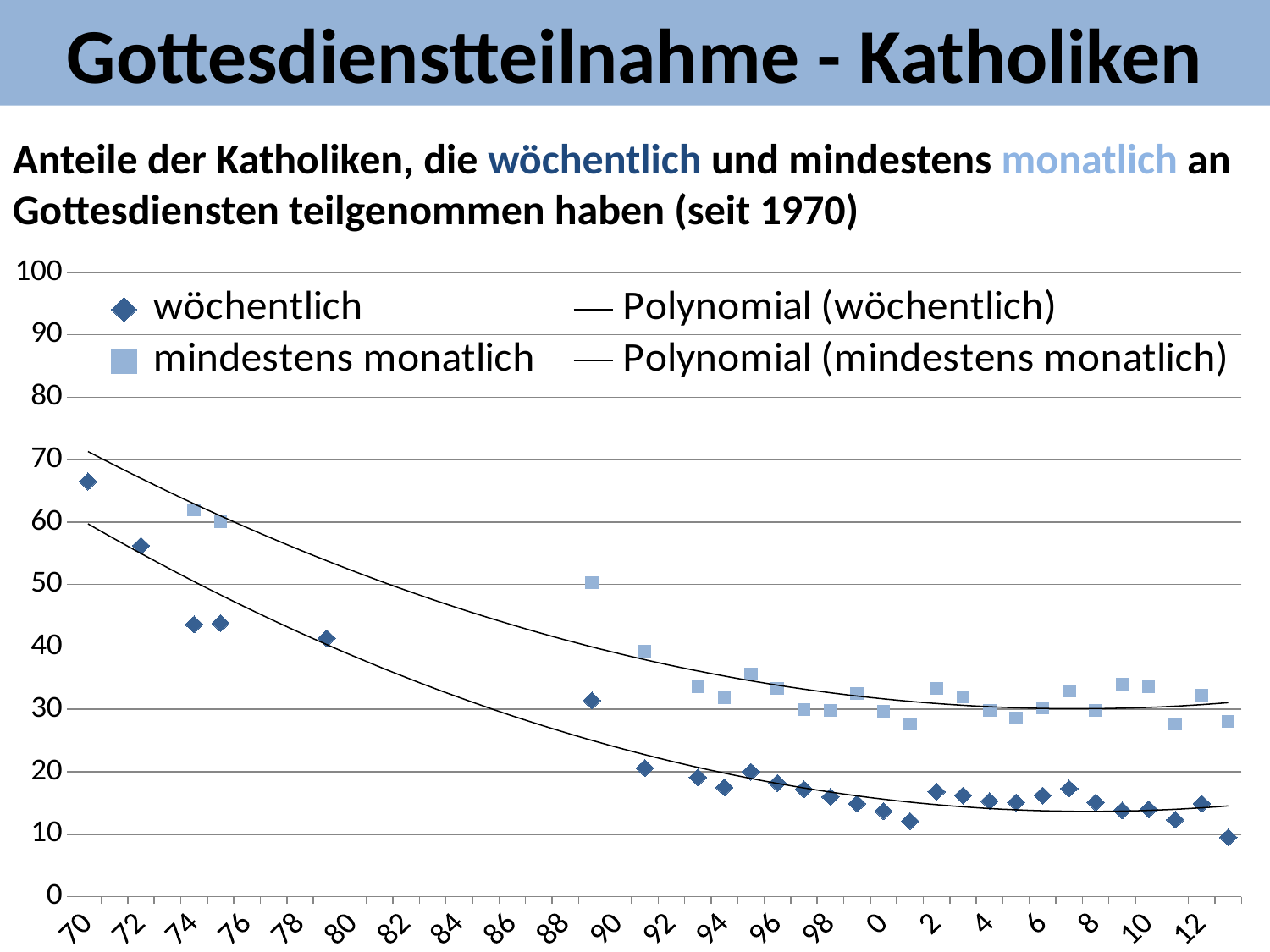
What kind of chart is shown on the slide? scatter chart Which legend entry is shown with a light blue square marker? mindestens monatlich Do the wöchentlich values generally rise or fall from 1970 to the 2010s? fall Is the mindestens monatlich value for 74 greater or less than 60? greater At 74, which series has the larger value, wöchentlich or mindestens monatlich? mindestens monatlich Is the wöchentlich value for 2 greater or less than 20? less How many entries does the chart legend list? 4 Which year has the highest wöchentlich value? 70 Is the wöchentlich value for 70 greater or less than 60? greater What is the title of the slide containing the chart? Gottesdienstteilnahme - Katholiken